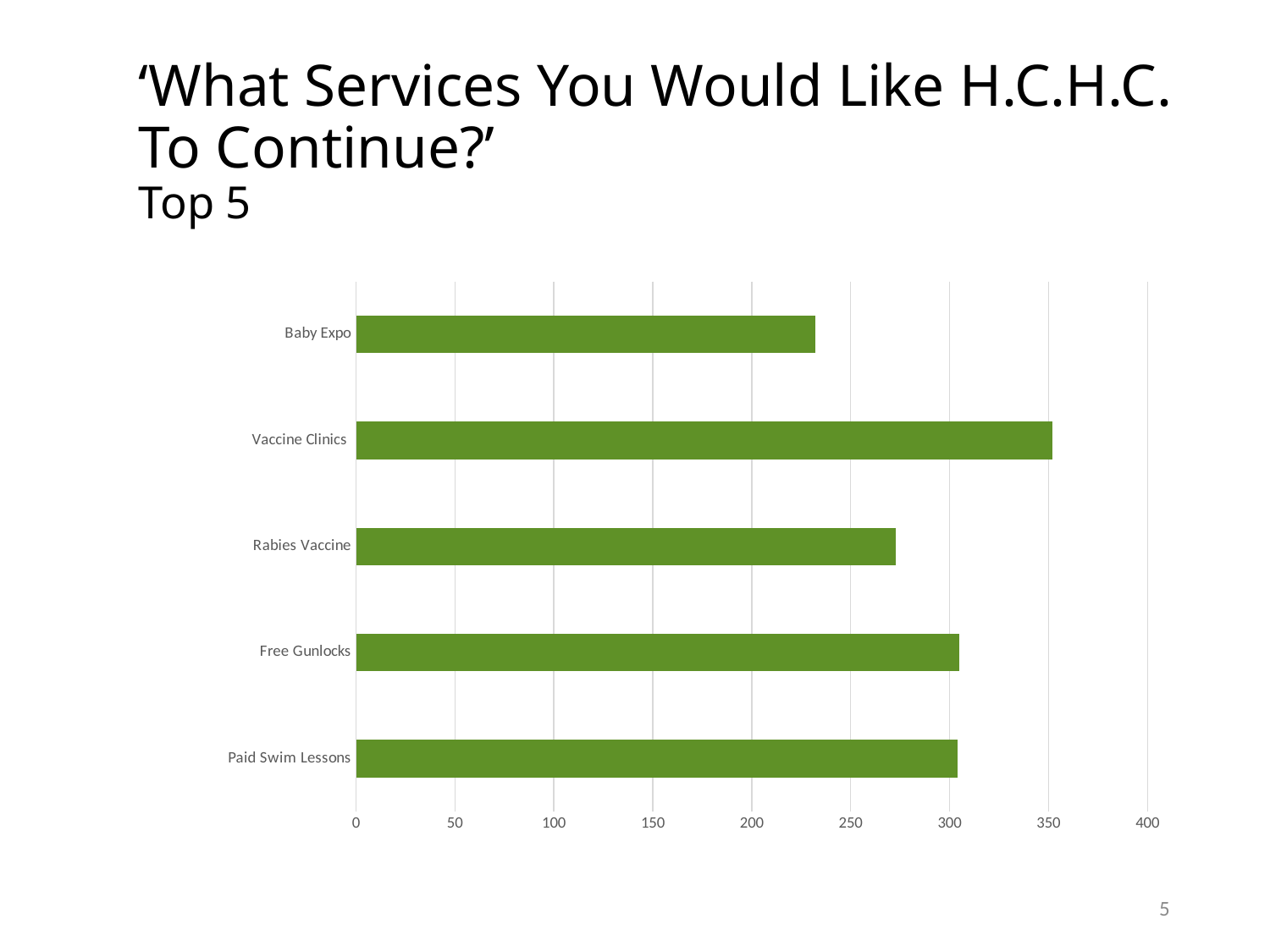
How many services are shown in the chart? 5 Which service has the lowest value in the chart? Baby Expo Is the value for Baby Expo greater or less than 250? less Is the value for Rabies Vaccine greater or less than 250? greater Is the value for Rabies Vaccine greater or less than 300? less What kind of chart is shown on the slide? bar chart Which is larger, the value for Free Gunlocks or the value for Rabies Vaccine? Free Gunlocks Which is larger, the value for Vaccine Clinics or the value for Baby Expo? Vaccine Clinics What is the highest value shown on the horizontal axis of the chart? 400 Which service has the highest value in the chart? Vaccine Clinics